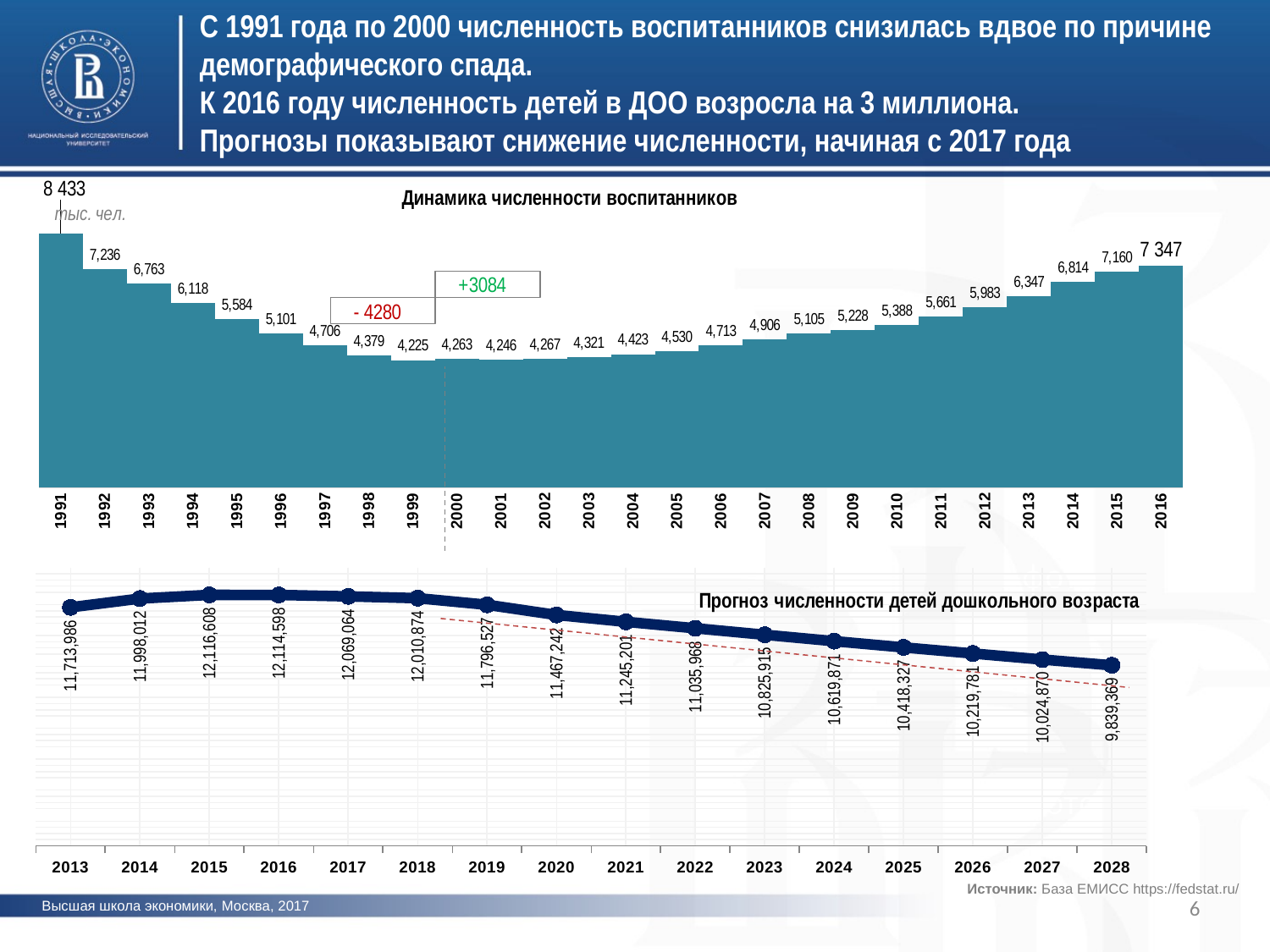
In the chart 'Прогноз численности детей дошкольного возраста', what is the value for 2028? 9,839,369 In the chart 'Динамика численности воспитанников', what is the value for 1999? 4,225 In the chart 'Динамика численности воспитанников', which year has the lowest value? 1999 In the chart 'Динамика численности воспитанников', what is the difference between the values for 1991 and 1992? 1,197 What kind of chart is 'Прогноз численности детей дошкольного возраста'? Line chart How many years are shown on the x axis of the chart 'Динамика численности воспитанников'? 26 In the chart 'Динамика численности воспитанников', what is the value for 2016? 7 347 In the chart 'Прогноз численности детей дошкольного возраста', do the values rise or fall from 2018 to 2028? Fall In the chart 'Прогноз численности детей дошкольного возраста', what is the value for 2020? 11,467,242 In the chart 'Динамика численности воспитанников', which is larger: the value for 2005 or the value for 2010? 2010 In the chart 'Прогноз численности детей дошкольного возраста', which year has the lowest value? 2028 In the chart 'Динамика численности воспитанников', which year has the highest value? 1991